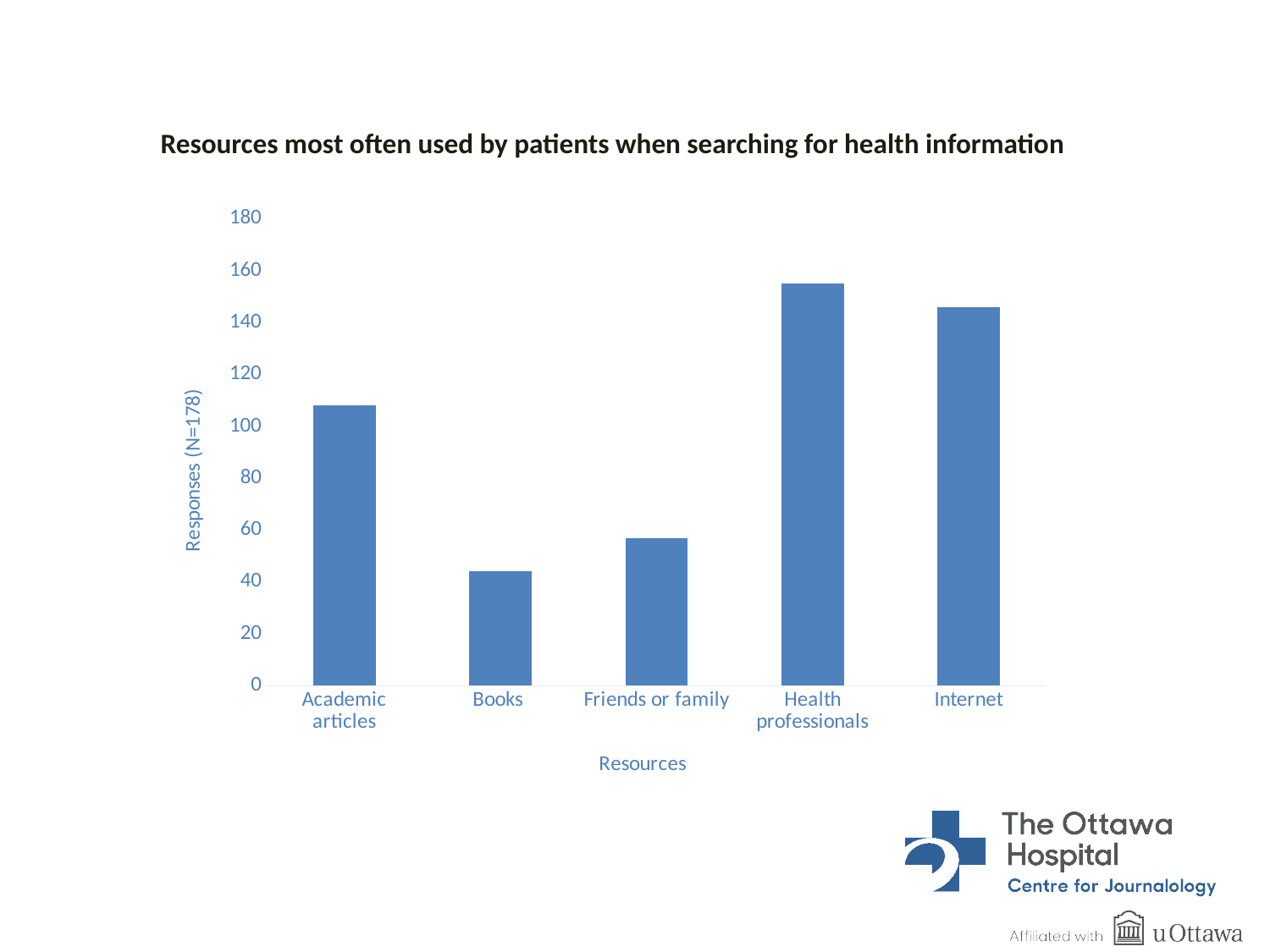
Which resource has the lowest number of responses? Books How many resource categories are shown on the x axis? 5 Is the value for Internet greater or less than 120? greater Is the value for Friends or family greater or less than 80? less What is the title of the chart? Resources most often used by patients when searching for health information Which has more responses, Academic articles or Friends or family? Academic articles Is the value for Health professionals greater or less than 140? greater What is the label of the y axis? Responses (N=178) What kind of chart is shown on the slide? bar chart Which resource has the highest number of responses? Health professionals